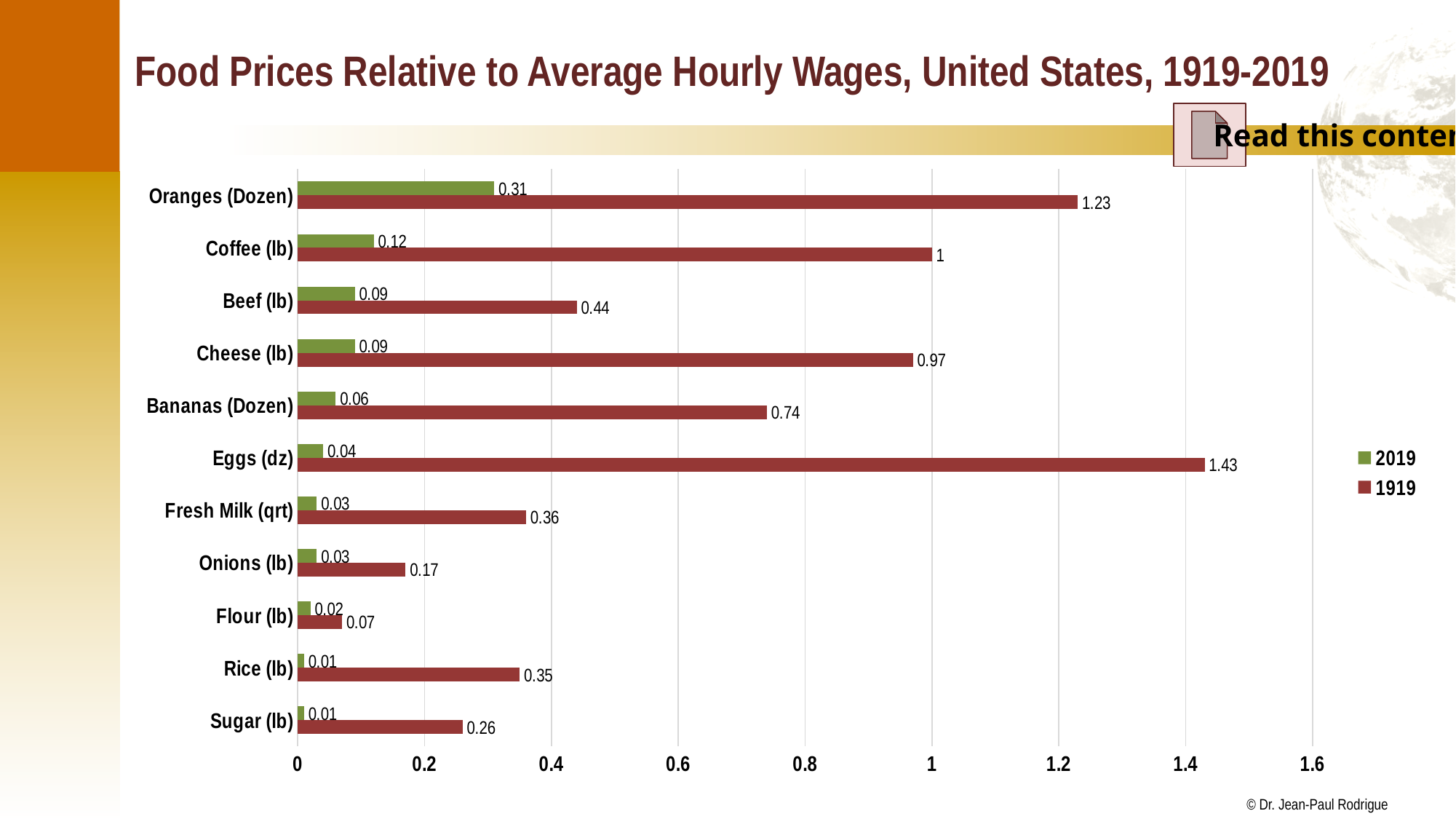
How many food categories are shown in the chart? 11 Which category has the highest 2019 value? Oranges (Dozen) What is the 2019 value for Oranges (Dozen)? 0.31 What is the 1919 value for Coffee (lb)? 1 What kind of chart is shown on the slide? Bar chart Which category has the highest 1919 value? Eggs (dz) Which category has the lowest 1919 value? Flour (lb) Which series is shown in green in the legend? 2019 Which is larger, the 1919 value for Bananas (Dozen) or the 1919 value for Beef (lb)? Bananas (Dozen) What is the 1919 value for Eggs (dz)? 1.43 What is the difference between the 1919 and 2019 values for Cheese (lb)? 0.88 How many series does the legend list? 2